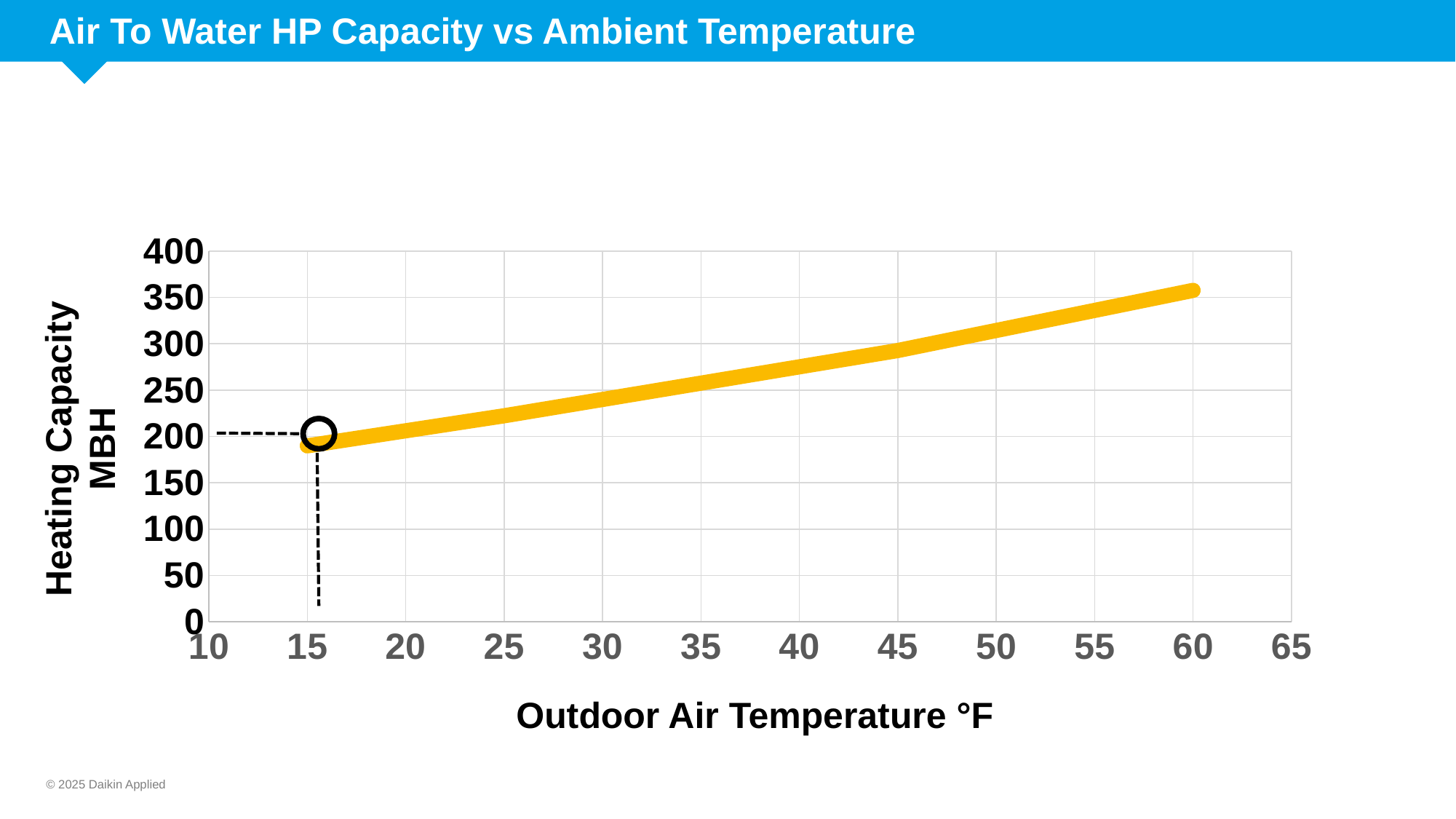
What kind of chart is shown on the slide? line chart Which has the larger heating capacity: 60 °F or 20 °F outdoor air temperature? 60 °F Is the heating capacity at 40 °F outdoor air temperature greater or less than 250 MBH? greater What is the label of the x axis? Outdoor Air Temperature °F At which outdoor air temperature shown on the line is the heating capacity lowest? 15 °F Does heating capacity rise or fall as outdoor air temperature increases along the x axis? rise At which outdoor air temperature shown on the line is the heating capacity highest? 60 °F Is the heating capacity at 50 °F outdoor air temperature greater or less than 250 MBH? greater Is the heating capacity at 60 °F outdoor air temperature greater or less than 300 MBH? greater What is the title of the chart? Air To Water HP Capacity vs Ambient Temperature